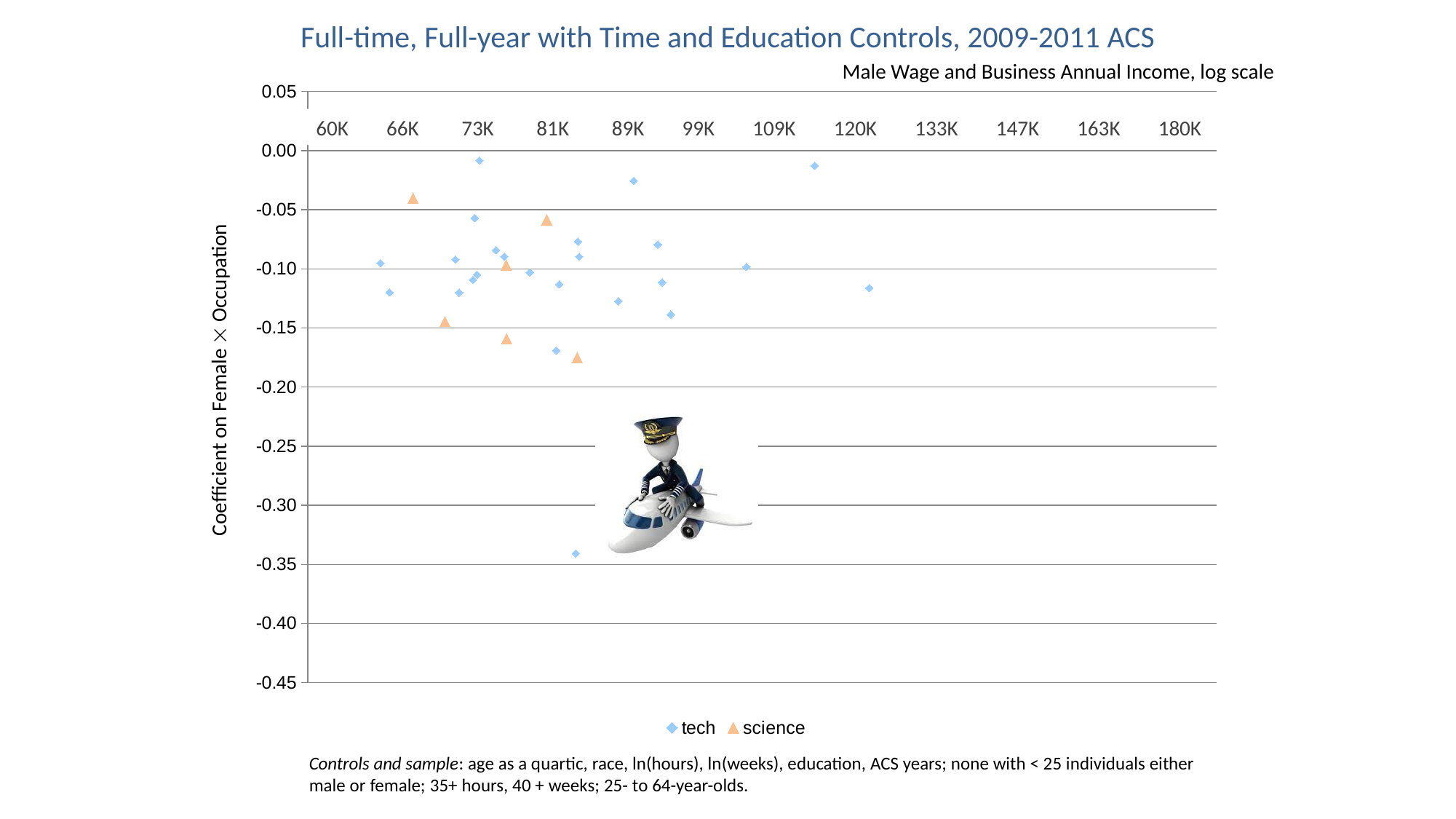
What are the two series named in the legend? tech and science What is the title of the chart? Full-time, Full-year with Time and Education Controls, 2009-2011 ACS Is the tech point plotted near 120K on the x axis greater or less than -0.15? greater Is the lowest plotted point on the chart greater or less than -0.30? less Is the highest science point greater or less than -0.05? greater How many series does the legend list? 2 Which series contains the lowest plotted point on the chart? tech What kind of chart is shown on the slide? scatter chart